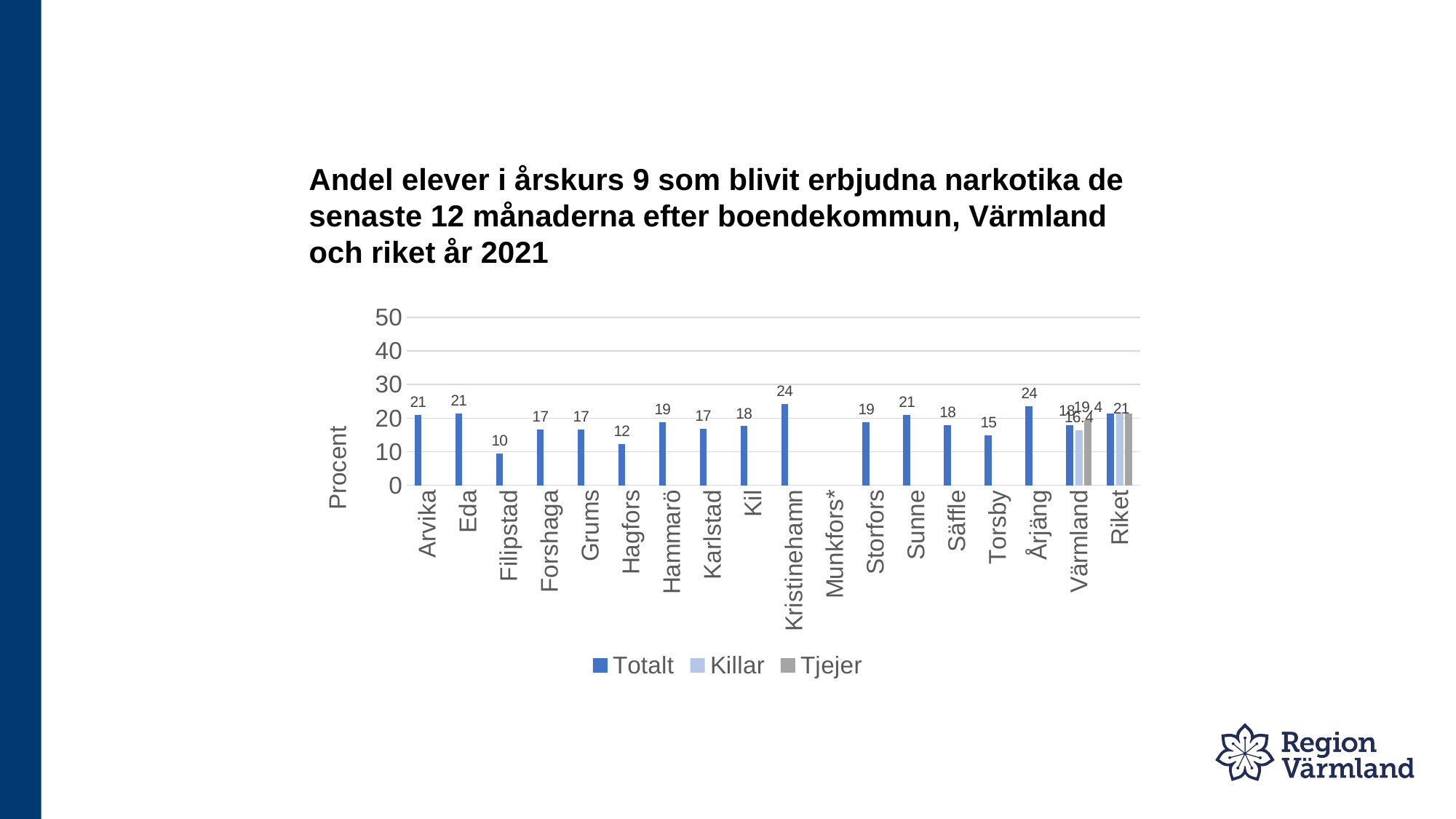
What is the difference between the Totalt values for Kristinehamn and Filipstad? 14 What is the difference between the Tjejer and Killar values for Värmland? 3 Which has a higher Totalt value, Hagfors or Torsby? Torsby What kind of chart is shown on the slide? bar chart What is the Tjejer value for Värmland? 19.4 How many categories are shown on the x axis? 18 How many series does the legend list? 3 What is the Totalt value for Filipstad? 10 What is the Killar value for Värmland? 16.4 What is the Totalt value for Kristinehamn? 24 Is the Totalt value for Filipstad greater or less than 20? less Which municipality has the lowest Totalt value? Filipstad